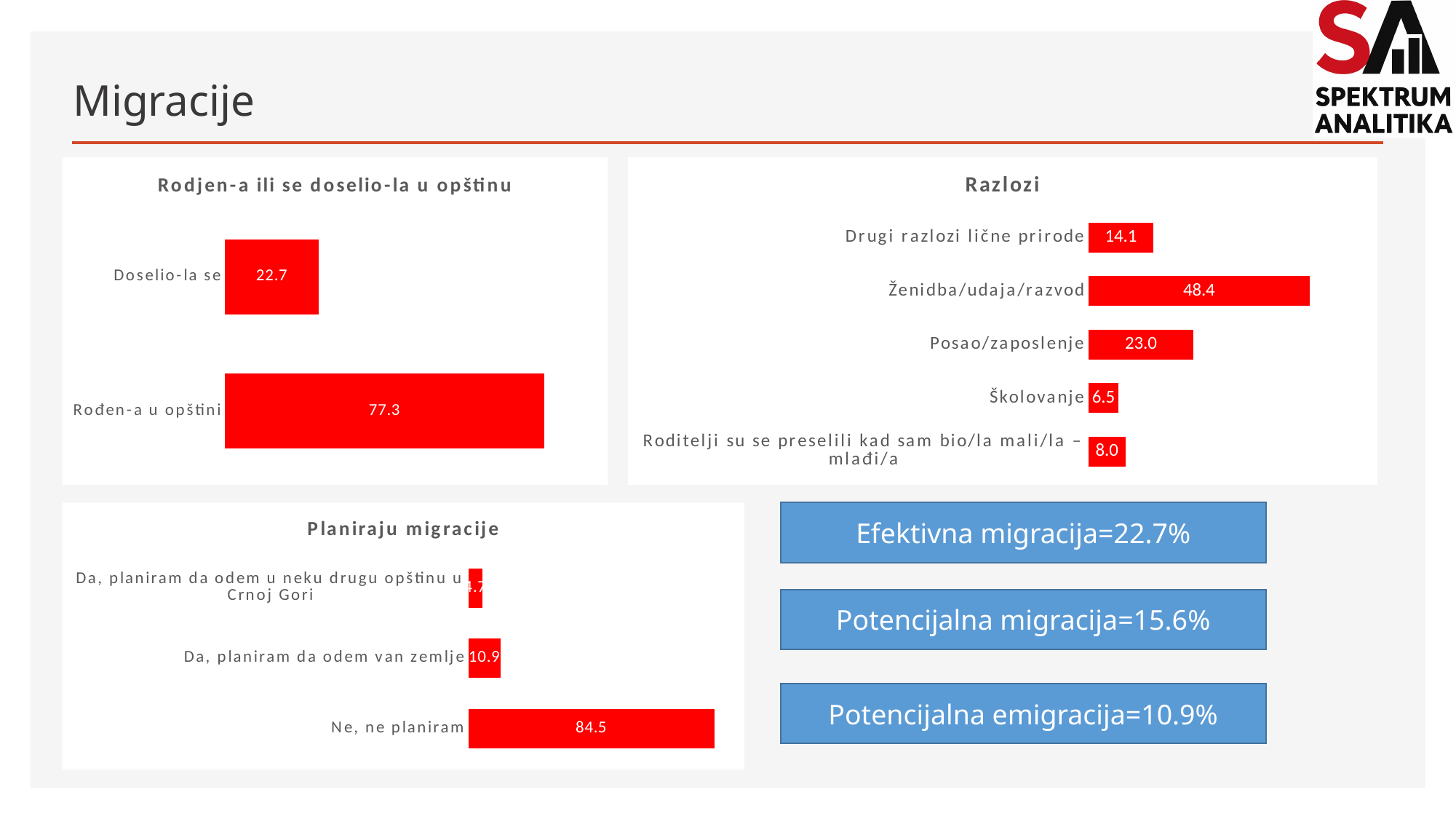
In the chart titled 'Planiraju migracije', what is the value for 'Da, planiram da odem van zemlje'? 10.9 In the chart titled 'Razlozi', what is the value for 'Posao/zaposlenje'? 23.0 In the chart titled 'Rodjen-a ili se doselio-la u opštinu', what is the value for 'Rođen-a u opštini'? 77.3 In the chart titled 'Rodjen-a ili se doselio-la u opštinu', what is the value for 'Doselio-la se'? 22.7 In the chart titled 'Razlozi', which is larger: 'Drugi razlozi lične prirode' or 'Roditelji su se preselili kad sam bio/la mali/la – mlađi/a'? Drugi razlozi lične prirode In the chart titled 'Razlozi', which category has the lowest value? Školovanje In the chart titled 'Razlozi', which category has the highest value? Ženidba/udaja/razvod In the chart titled 'Planiraju migracije', what is the value for 'Ne, ne planiram'? 84.5 In the chart titled 'Razlozi', how many categories are shown? 5 In the chart titled 'Rodjen-a ili se doselio-la u opštinu', what is the difference between 'Rođen-a u opštini' and 'Doselio-la se'? 54.6 In the chart titled 'Razlozi', what is the value for 'Ženidba/udaja/razvod'? 48.4 What type of chart is the chart titled 'Planiraju migracije'? Bar chart